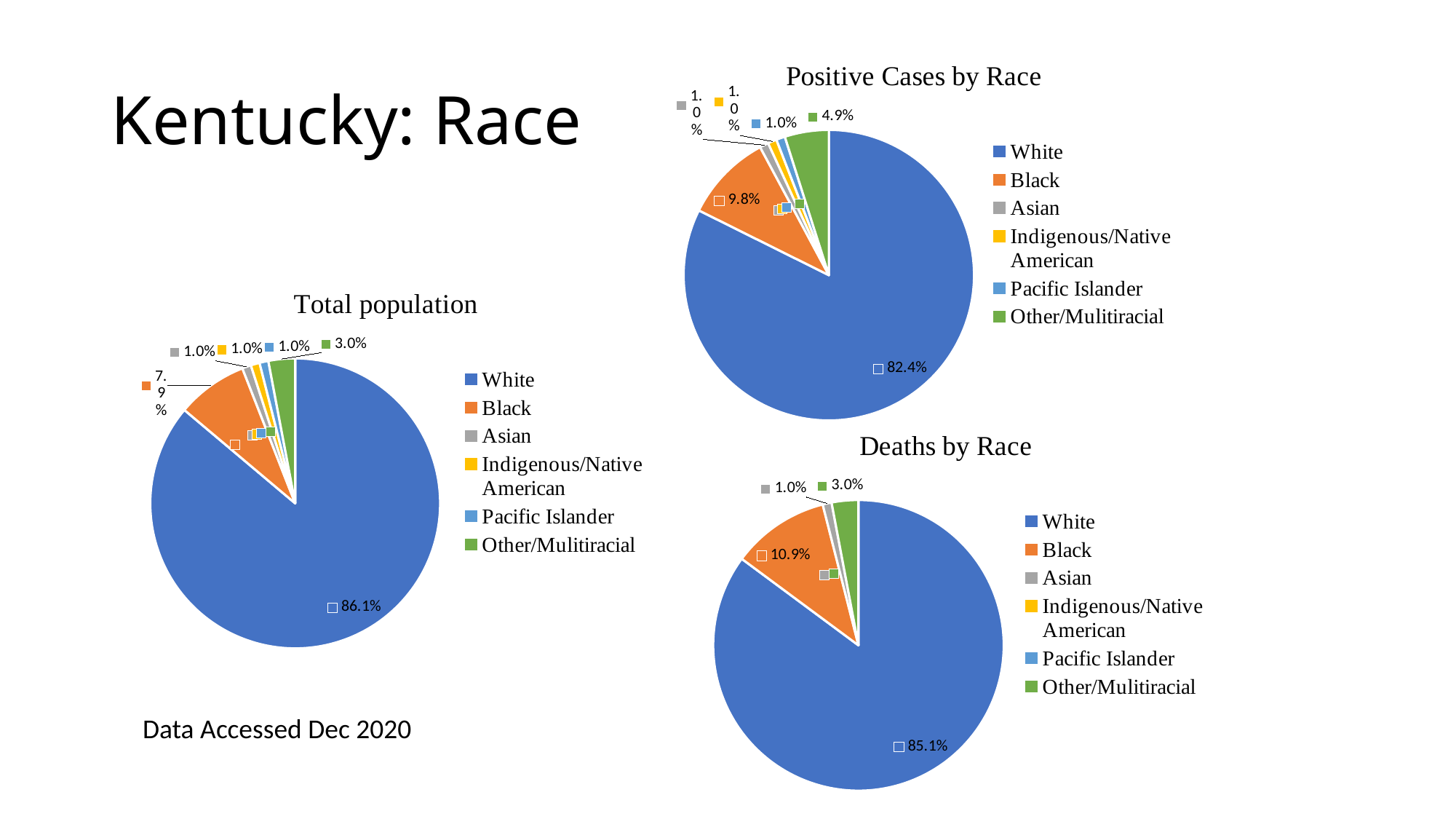
In the Positive Cases by Race chart, what percentage is shown for Black? 9.8% In the Total population chart, what percentage is shown for Black? 7.9% Which is larger: the Black share in the Deaths by Race chart or the Black share in the Total population chart? Deaths by Race In the Positive Cases by Race chart, what percentage is shown for Other/Mulitiracial? 4.9% In the Positive Cases by Race chart, what is the difference between the White and Black percentages? 72.6% In the Deaths by Race chart, which category has the largest slice? White In the Deaths by Race chart, what percentage is shown for Black? 10.9% What kind of chart is the Total population chart? Pie chart How many entries does the legend of the Positive Cases by Race chart list? 6 In the Deaths by Race chart, what percentage is shown for White? 85.1% In the Total population chart, what is the combined share of Asian, Indigenous/Native American and Pacific Islander? 3.0% In the Total population chart, what share of the pie is White? 86.1%